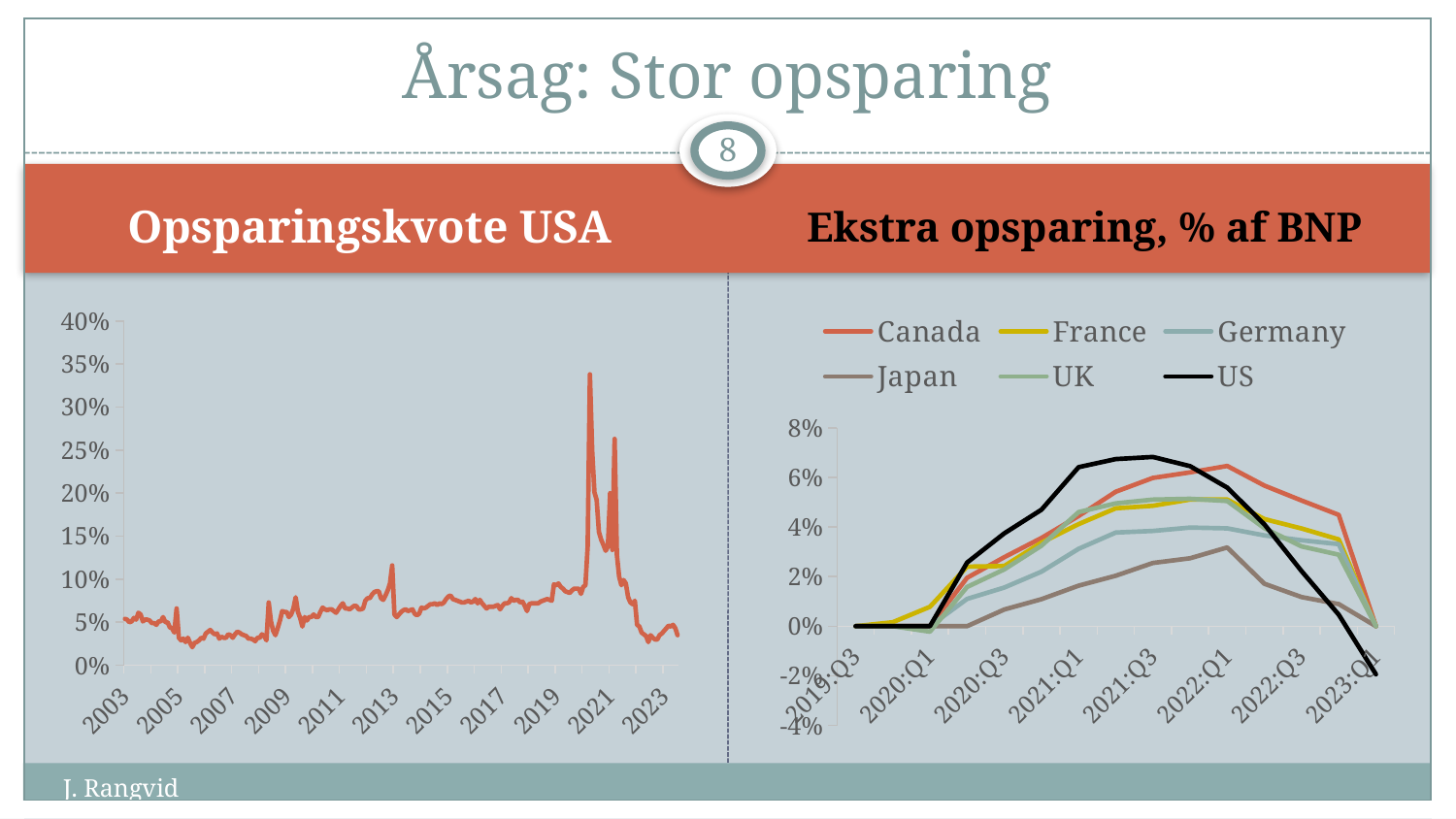
In the right chart "Ekstra opsparing, % af BNP", is the value for Canada at 2022:Q1 greater or less than 6%? greater In the left chart "Opsparingskvote USA", is the peak value around 2020 greater or less than 30%? greater How many series does the legend of the right chart "Ekstra opsparing, % af BNP" list? 6 In the left chart "Opsparingskvote USA", is the value at 2023 greater or less than 5%? less In the right chart "Ekstra opsparing, % af BNP", which is larger at 2021:Q1, US or Japan? US Which series in the right chart "Ekstra opsparing, % af BNP" is drawn in black? US In the right chart "Ekstra opsparing, % af BNP", which series reaches the highest value? US In the right chart "Ekstra opsparing, % af BNP", which series is lowest at 2022:Q1? Japan In the right chart "Ekstra opsparing, % af BNP", does the US line rise or fall between 2022:Q1 and 2023:Q1? fall What kind of chart is the left chart titled "Opsparingskvote USA"? line chart